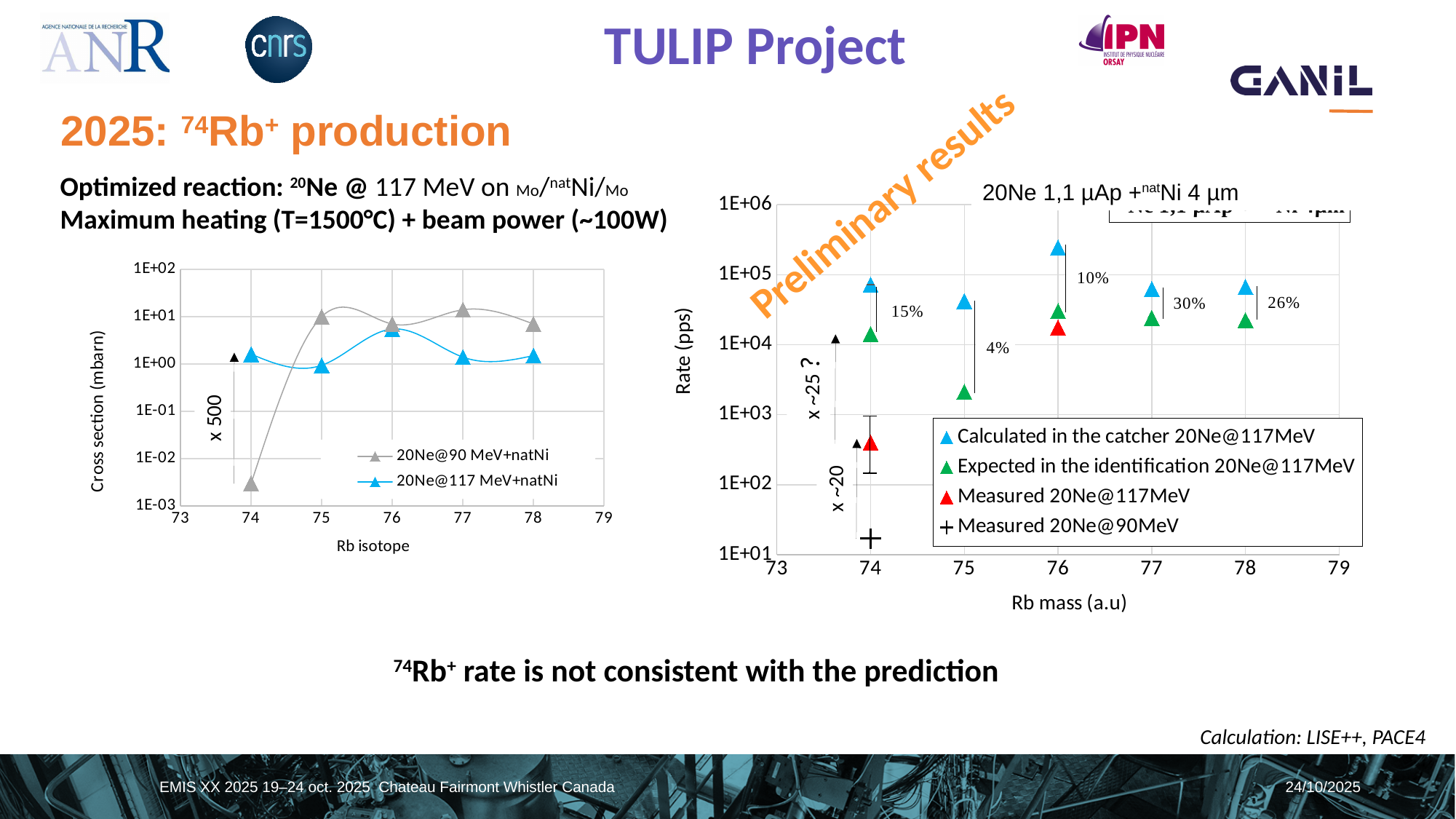
On the left chart (Cross section vs Rb isotope), how many Rb isotopes are plotted for the 20Ne@117 MeV+natNi series? 5 On the left chart (Cross section vs Rb isotope), is the 20Ne@90 MeV+natNi value at Rb isotope 74 greater or less than 1E-02? less On the right chart (Rate (pps) vs Rb mass), is the 'Measured 20Ne@117MeV' value at Rb mass 74 greater or less than 1E+03? less On the left chart (Cross section vs Rb isotope), which series has the higher cross section at Rb isotope 77? 20Ne@90 MeV+natNi On the left chart (Cross section vs Rb isotope), is the 20Ne@117 MeV+natNi value at Rb isotope 74 greater or less than 1E+00? greater On the left chart (Cross section vs Rb isotope), what kind of chart is it? line chart On the right chart (Rate (pps) vs Rb mass), at which Rb mass is the 'Calculated in the catcher 20Ne@117MeV' rate highest? 76 On the left chart (Cross section vs Rb isotope), which series has the higher cross section at Rb isotope 74? 20Ne@117 MeV+natNi On the right chart (Rate (pps) vs Rb mass), how many series does the legend list? 4 On the left chart (Cross section vs Rb isotope), how many series does the legend list? 2 On the right chart (Rate (pps) vs Rb mass), what percentage label is shown next to the points at Rb mass 77? 30%